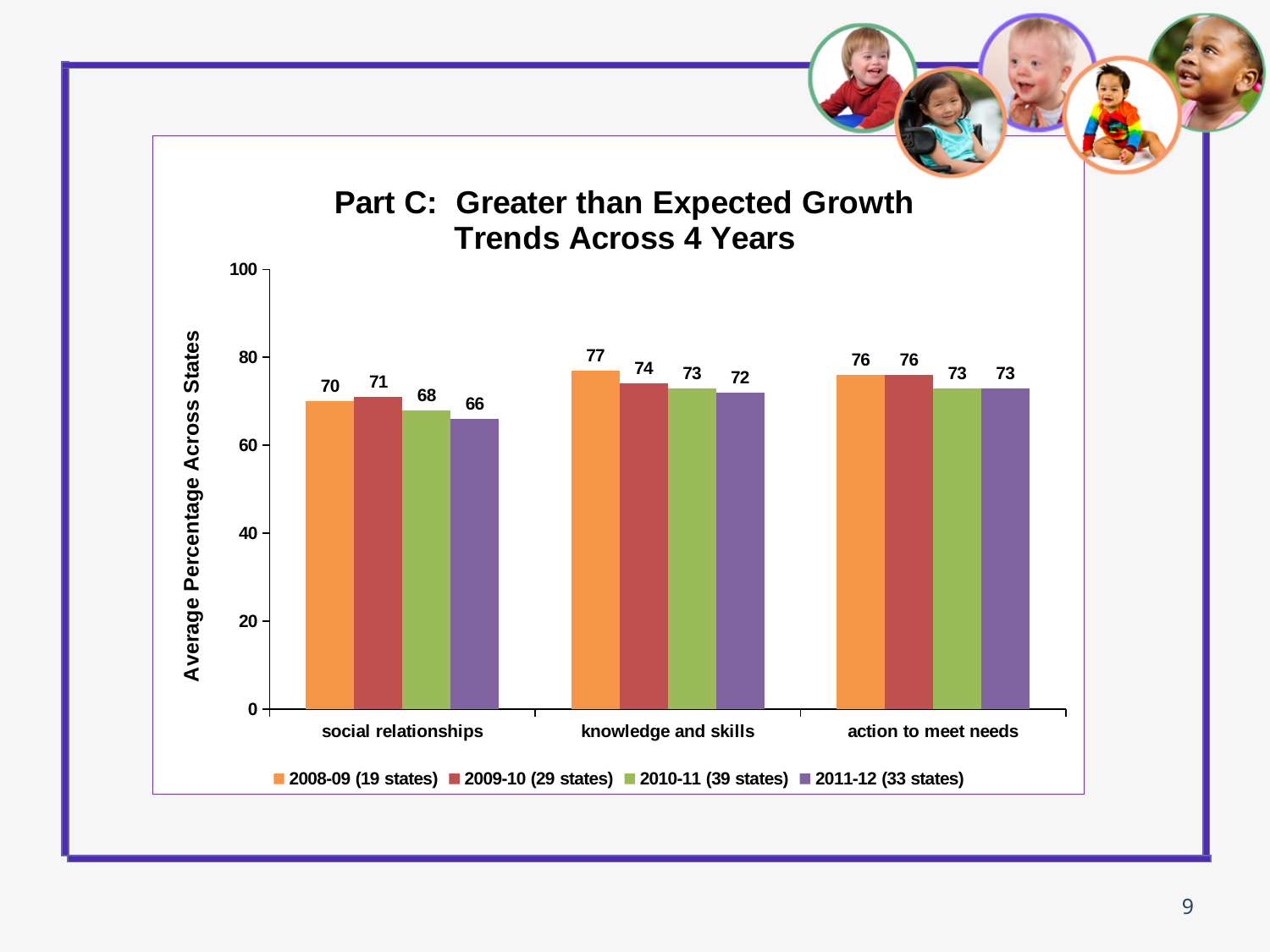
How many categories are shown on the x axis? 3 What is the value for knowledge and skills in 2011-12 (33 states)? 72 What is the title of the chart? Part C: Greater than Expected Growth Trends Across 4 Years Which is larger for knowledge and skills: the 2008-09 (19 states) value or the 2010-11 (39 states) value? 2008-09 (19 states) Do the values for social relationships rise or fall from 2009-10 (29 states) to 2011-12 (33 states)? fall Which category has the highest value in the 2008-09 (19 states) series? knowledge and skills Which category has the lowest value in the 2011-12 (33 states) series? social relationships What is the difference between the 2008-09 (19 states) and 2011-12 (33 states) values for social relationships? 4 What kind of chart is shown on the slide? bar chart How many series does the legend list? 4 What is the value for action to meet needs in 2009-10 (29 states)? 76 What is the value for social relationships in 2008-09 (19 states)? 70